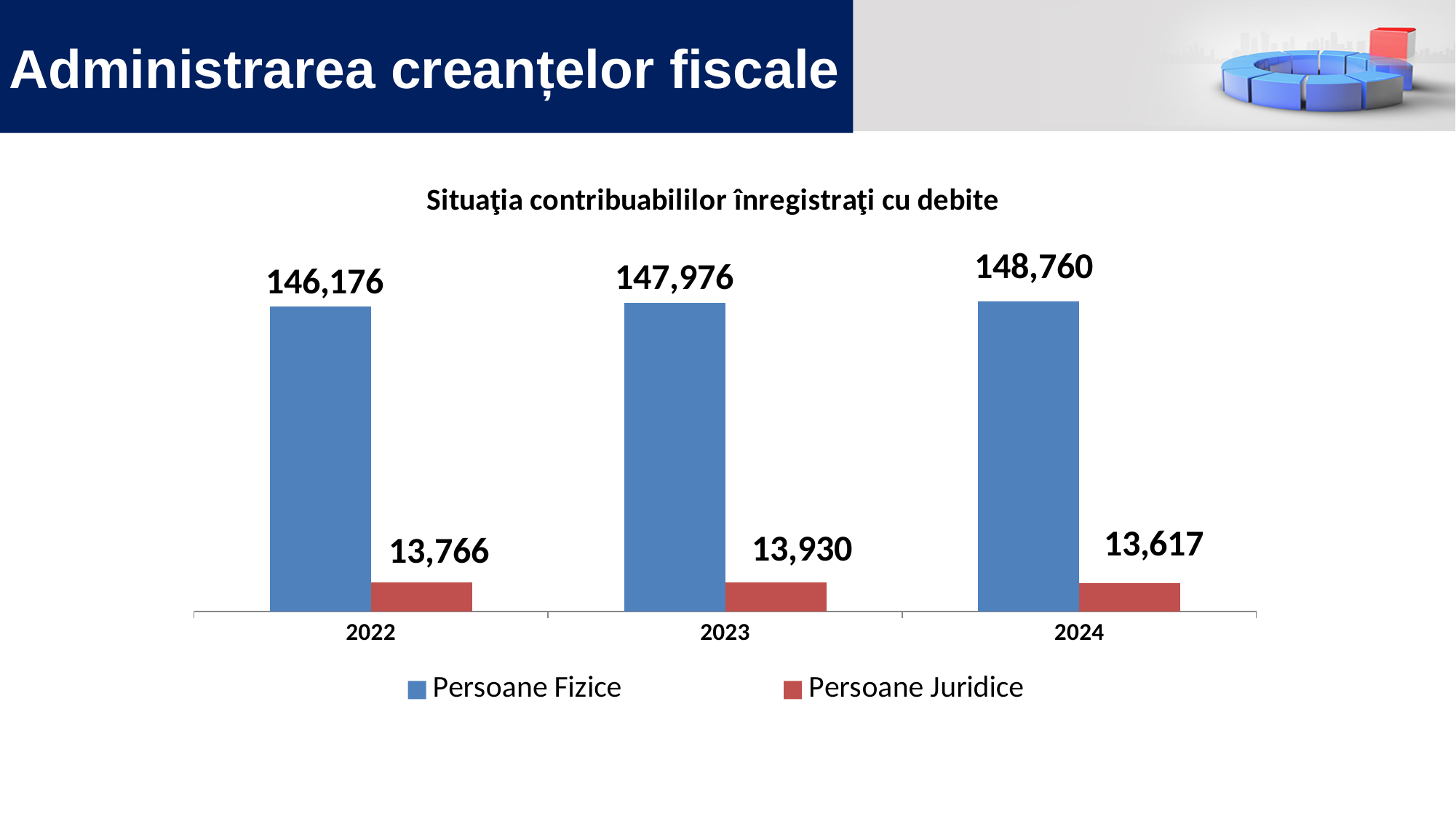
Which is larger: Persoane Juridice in 2022 or Persoane Juridice in 2024? Persoane Juridice in 2022 What is the difference between the Persoane Fizice values for 2024 and 2022? 2,584 What is the value for Persoane Fizice in 2022? 146,176 What is the value for Persoane Juridice in 2024? 13,617 In which year is the Persoane Juridice value lowest? 2024 How many years are shown on the x axis? 3 In which year is the Persoane Fizice value highest? 2024 What is the value for Persoane Fizice in 2024? 148,760 What kind of chart is shown on the slide? Bar chart What is the difference between the Persoane Juridice values for 2023 and 2022? 164 How many series does the legend list? 2 What is the value for Persoane Juridice in 2023? 13,930